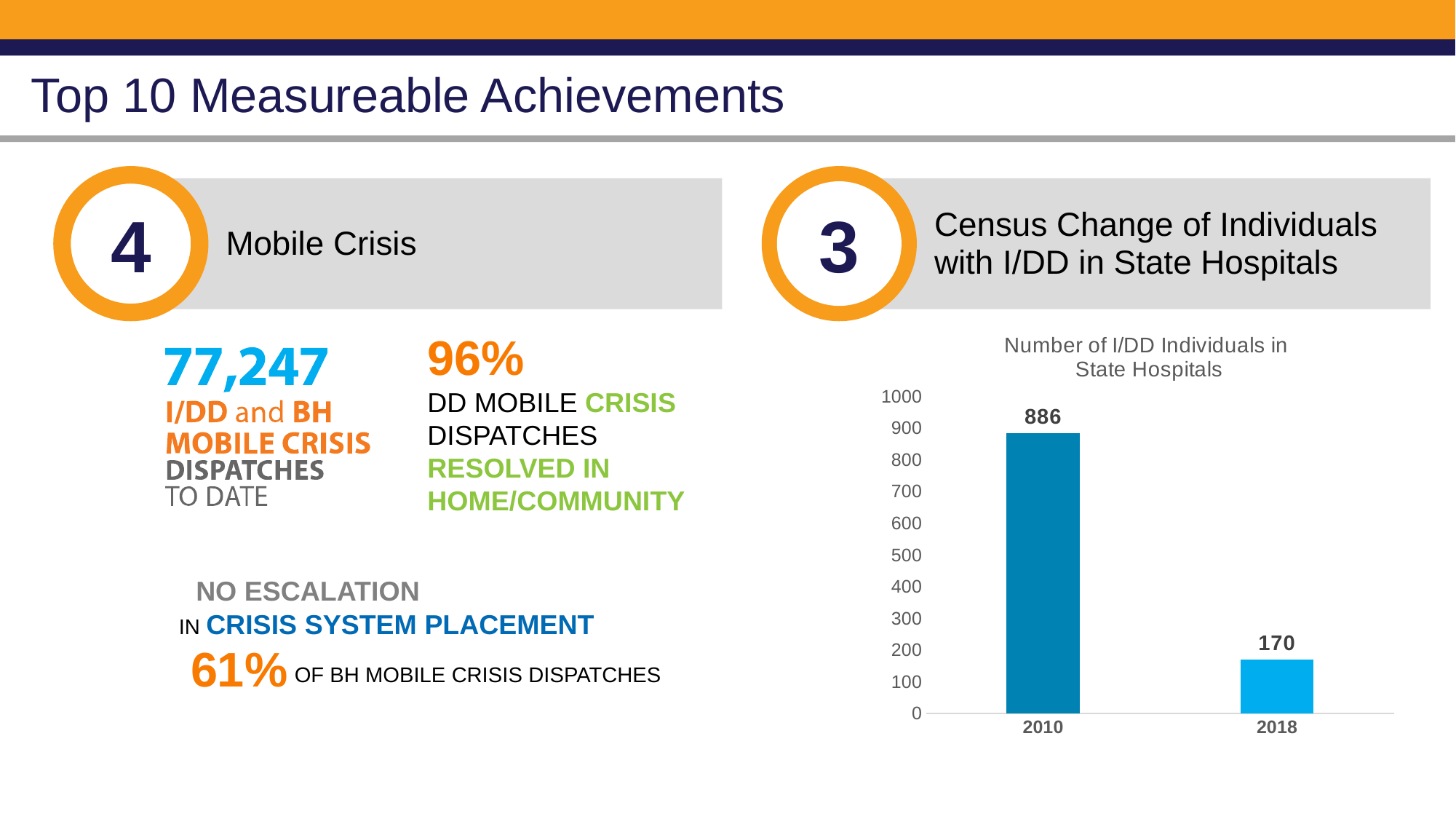
What is the value for 2018 in the chart? 170 Which is larger, the value for 2010 or the value for 2018? 2010 How many bars are plotted in the chart? 2 What kind of chart is shown on the slide? bar chart Which year has the lowest number of I/DD individuals in state hospitals? 2018 Is the value for 2018 greater or less than 200? less Which year has the highest number of I/DD individuals in state hospitals? 2010 Is the value for 2010 greater or less than 800? greater What is the value for 2010 in the chart? 886 What is the difference between the 2010 and 2018 values? 716 What is the title of the chart? Number of I/DD Individuals in State Hospitals Do the values rise or fall from 2010 to 2018? fall